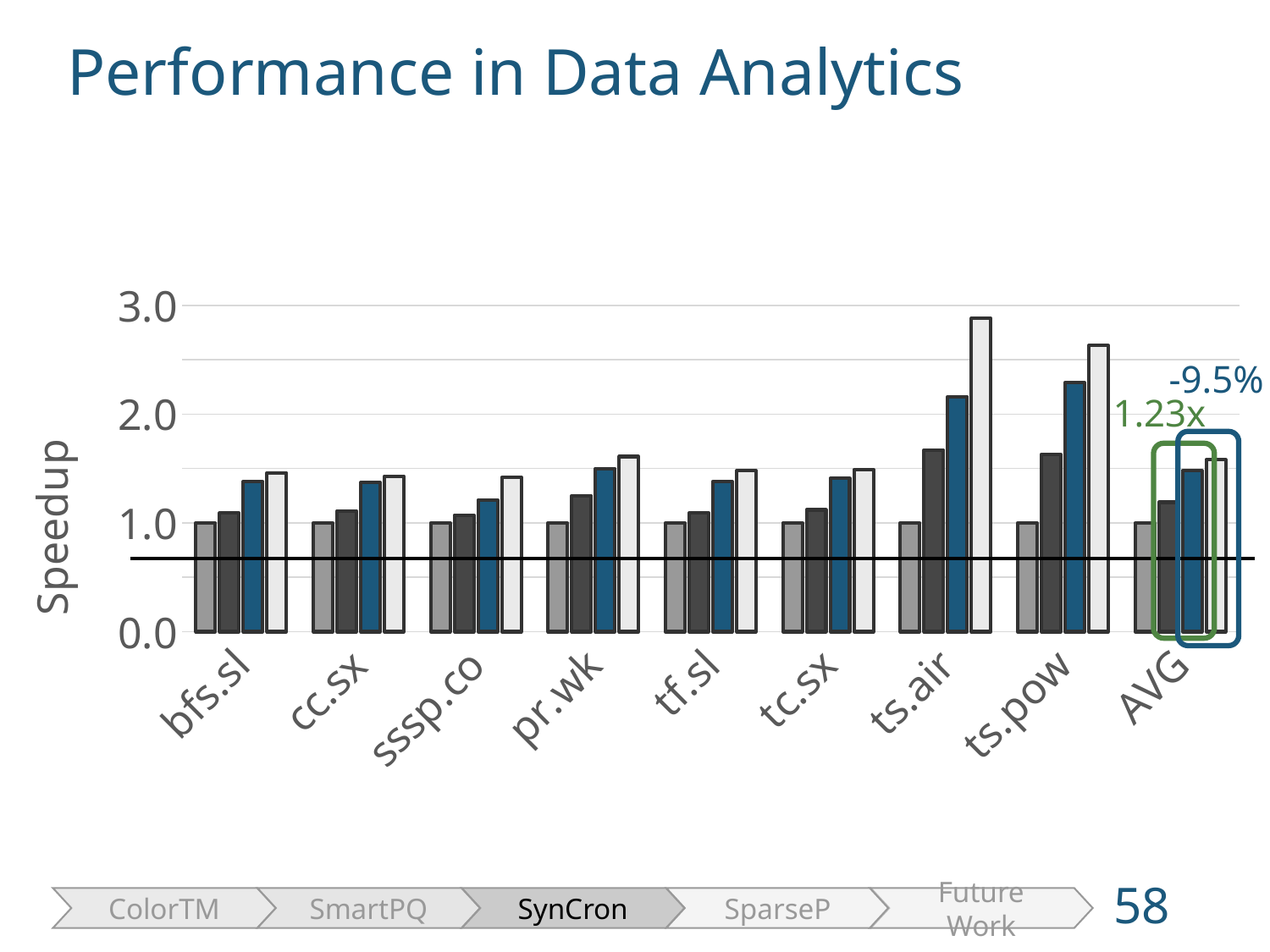
Is the value of the blue bar for ts.pow greater or less than 2.0? greater What is the title of the slide containing the chart? Performance in Data Analytics What kind of chart is shown on the slide? bar chart What is the speedup value of the first (light grey) bar for bfs.sl? 1.0 How many bars are plotted for each category in the chart? 4 Which category has the tallest bar in the chart? ts.air Is the value of the tallest bar for ts.air greater or less than 2.0? greater Is the value of the blue bar for bfs.sl greater or less than 2.0? less Which category has the larger fourth (lightest) bar, ts.air or bfs.sl? ts.air How many categories are shown along the x axis of the chart? 9 What annotation in green is written above the AVG group in the chart? 1.23x What is the speedup value of the first (light grey) bar for AVG? 1.0